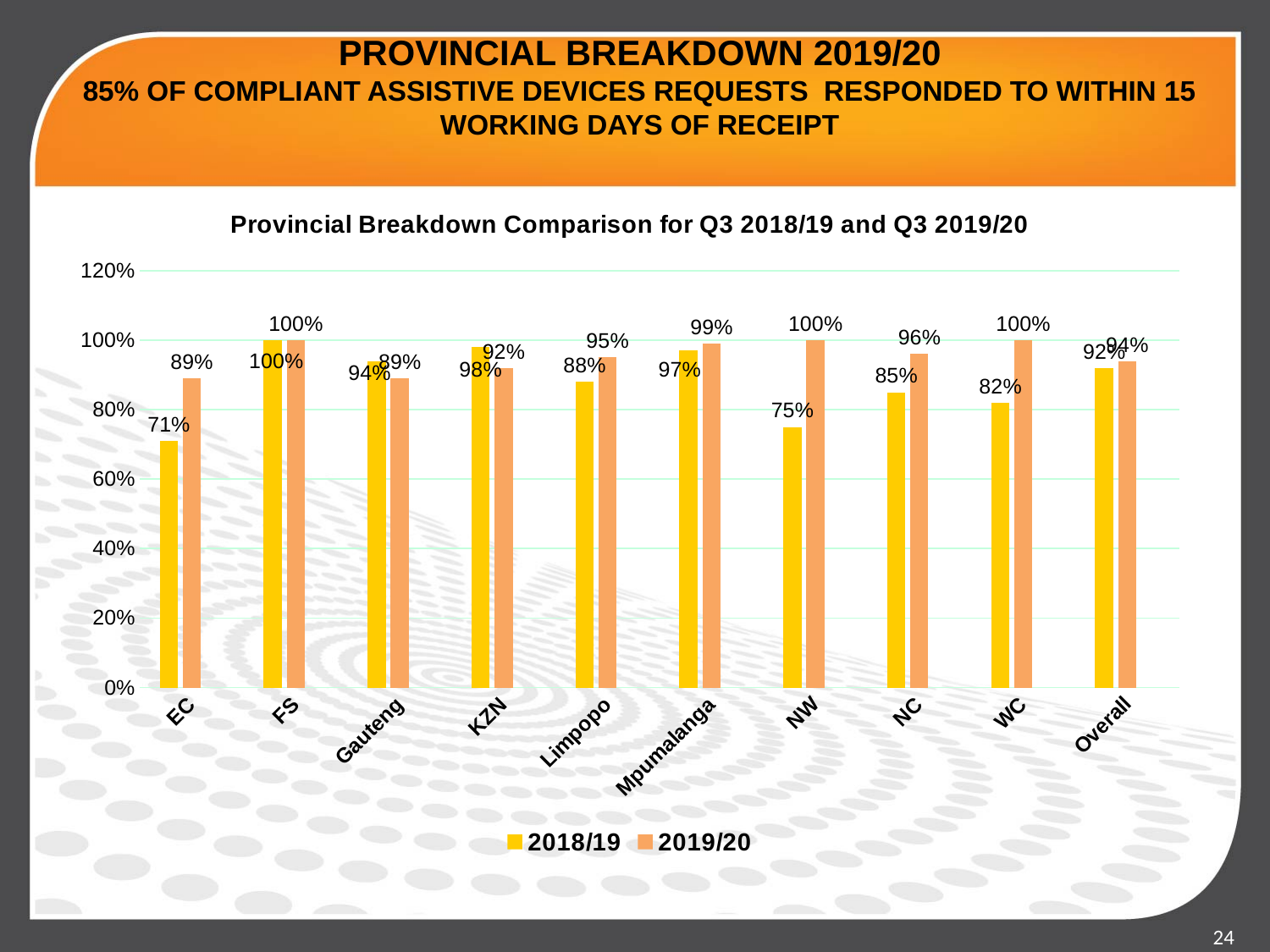
What kind of chart is shown on the slide? Bar chart Which category has the highest 2018/19 value? FS What is the 2018/19 value for WC? 82% What is the 2019/20 value for Limpopo? 95% Which is larger for Gauteng, the 2018/19 value or the 2019/20 value? 2018/19 How many series does the legend list? 2 What is the title of the chart? Provincial Breakdown Comparison for Q3 2018/19 and Q3 2019/20 How many categories are shown on the x axis? 10 What is the difference between the 2019/20 and 2018/19 values for NW? 25% What is the 2018/19 value for EC? 71% What is the 2019/20 value for NW? 100% Which province has the lowest 2018/19 value? EC